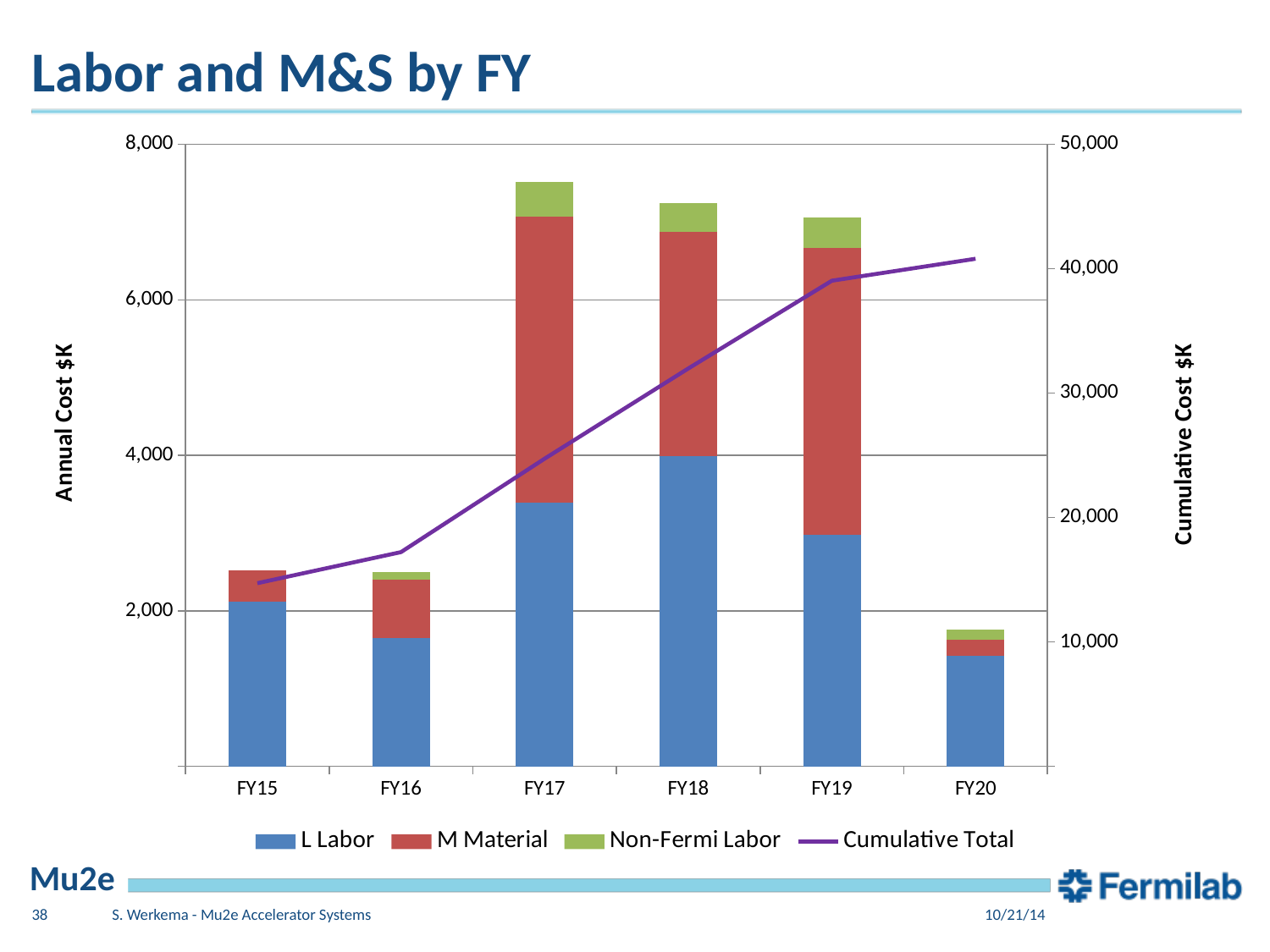
Which fiscal year has the largest L Labor value? FY18 How many series does the chart legend list? 4 Which fiscal year has the tallest stacked bar for annual cost? FY17 Is the L Labor value for FY16 greater or less than 2,000? less Which is larger, the L Labor value for FY17 or for FY18? FY18 Does the Cumulative Total line rise or fall from FY15 to FY20? rise What kind of chart is shown on the slide? Stacked bar chart with a line Which fiscal year has the shortest stacked bar for annual cost? FY20 Is the total annual cost for FY17 greater or less than 6,000? greater How many fiscal years are shown on the x axis of the chart? 6 Is the total annual cost for FY20 greater or less than 2,000? less